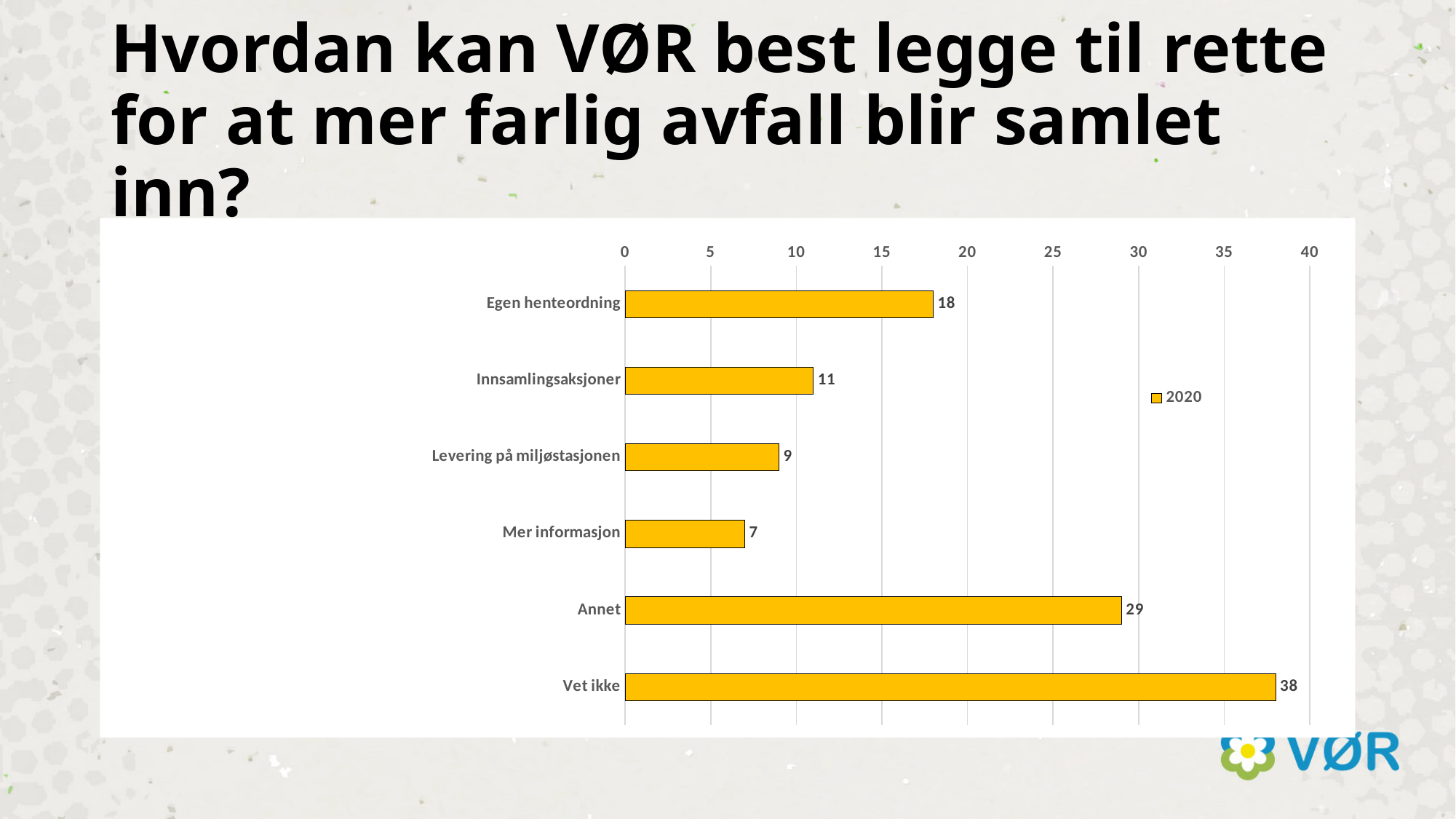
How many categories are shown in the chart? 6 Which category has the highest value? Vet ikke Which category has the lowest value? Mer informasjon Which is larger, the value for Egen henteordning or the value for Innsamlingsaksjoner? Egen henteordning How many series does the legend list? 1 What is the value for Levering på miljøstasjonen? 9 What kind of chart is shown on the slide? Bar chart What is the value for Mer informasjon? 7 Is the value for Annet greater or less than 25? greater What is the value for Egen henteordning? 18 What is the value for Innsamlingsaksjoner? 11 What is the difference between the values for Vet ikke and Annet? 9